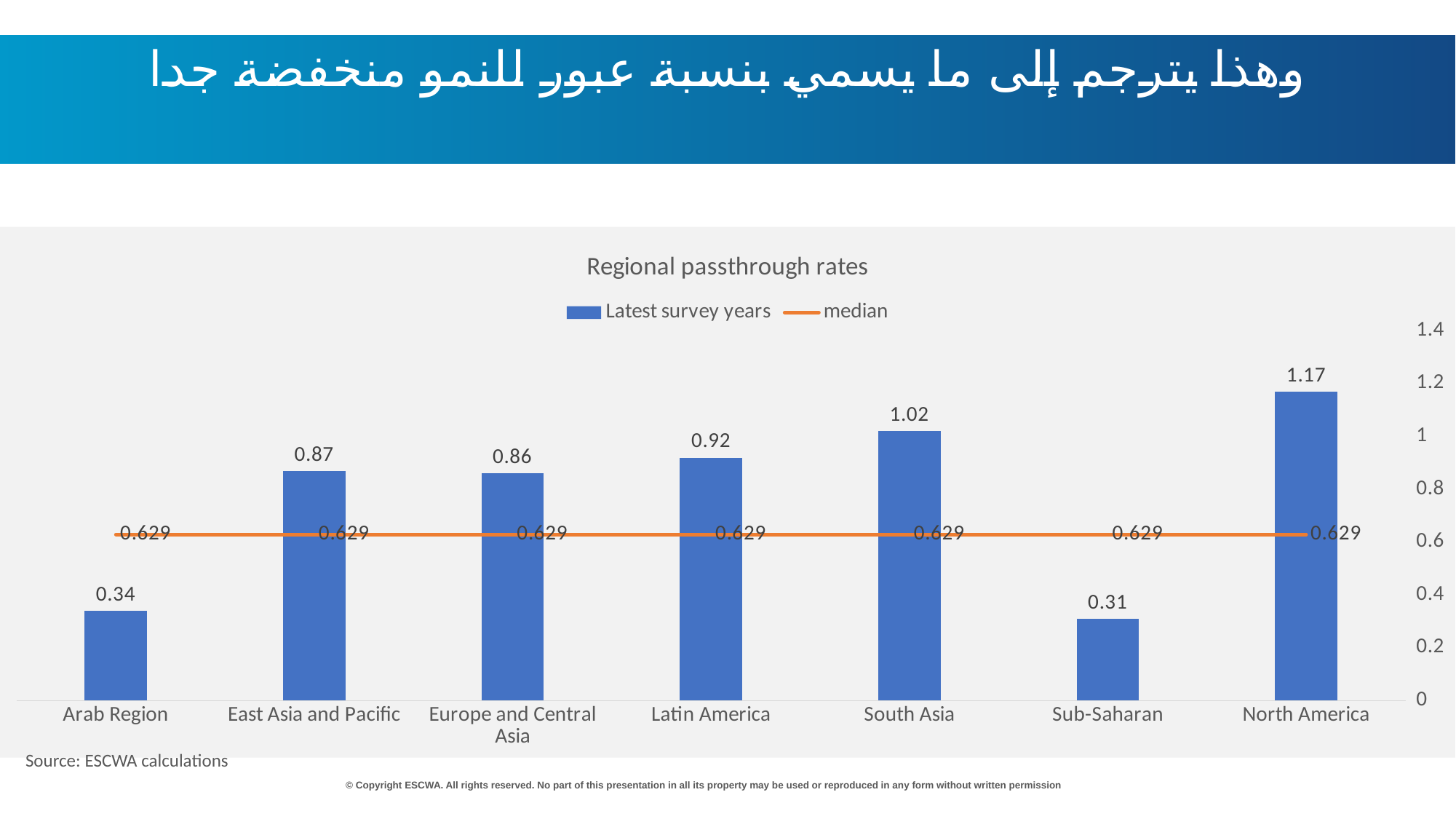
What kind of chart is used for the Latest survey years series? bar chart Is the value for Sub-Saharan greater or less than 0.4? less How many series does the legend list? 2 What is the difference between the values for North America and the Arab Region? 0.83 Which region has the highest passthrough rate in the Latest survey years series? North America What is the median value shown by the orange line? 0.629 What is the title of the chart? Regional passthrough rates Which region has the lowest passthrough rate in the Latest survey years series? Sub-Saharan How many regions are shown on the x axis? 7 What is the value for the Arab Region in the Latest survey years series? 0.34 What is the value for North America in the Latest survey years series? 1.17 Which is larger, the value for South Asia or the value for Latin America? South Asia